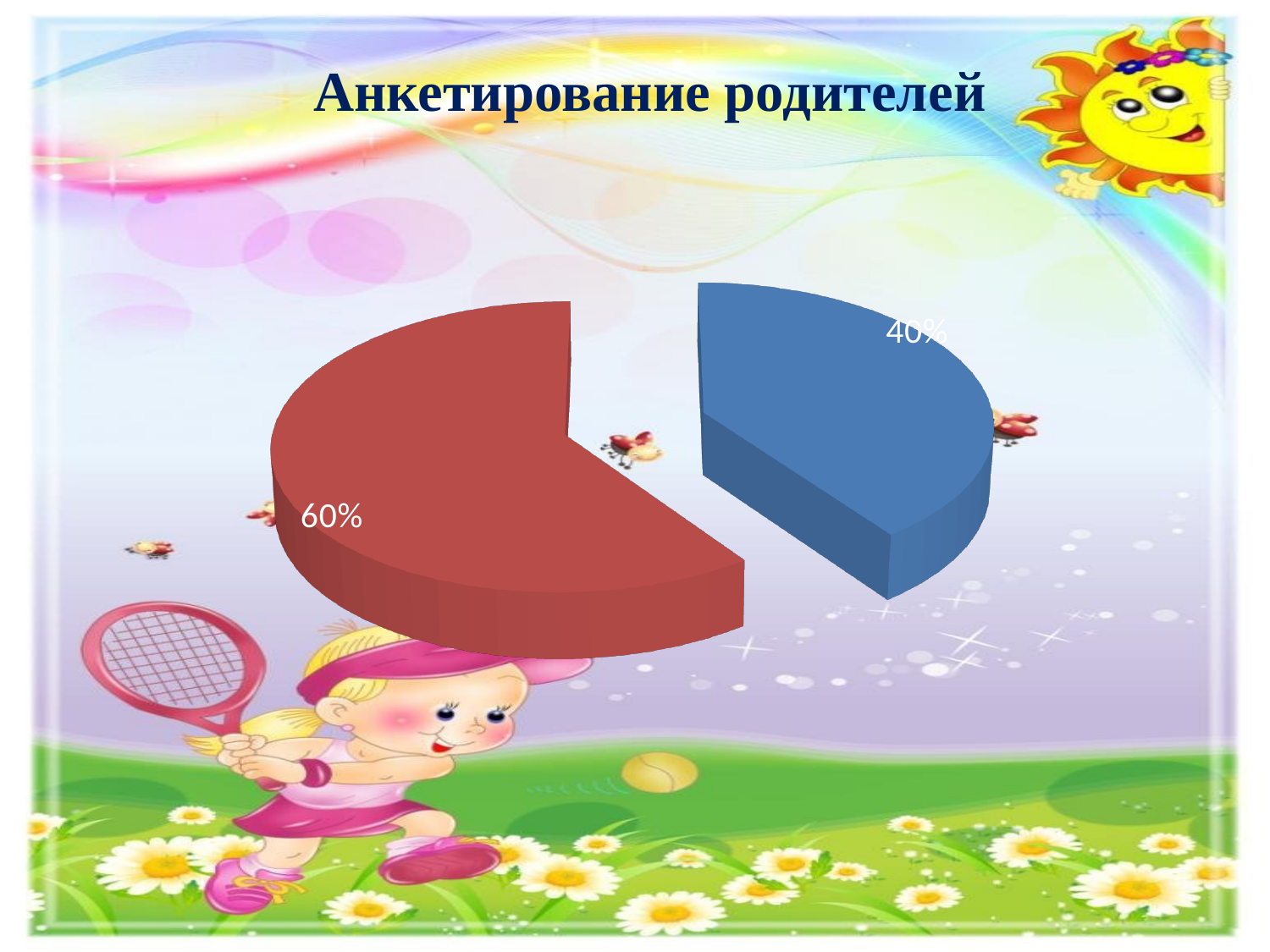
How many slices does the pie chart have? 2 What is the title of the slide containing the pie chart? Анкетирование родителей Which slice of the pie chart is the smallest? the blue slice (40%) What is the difference in percentage points between the red slice and the blue slice? 20% What kind of chart is shown on the slide? pie chart Which is larger, the red slice or the blue slice? the red slice Is the value of the blue slice greater or less than 50%? less Which slice of the pie chart is the largest? the red slice (60%) What percentage is shown on the blue slice of the pie chart? 40% What colours are the two slices of the pie chart? red and blue Is the value of the red slice greater or less than 50%? greater What percentage is shown on the red slice of the pie chart? 60%